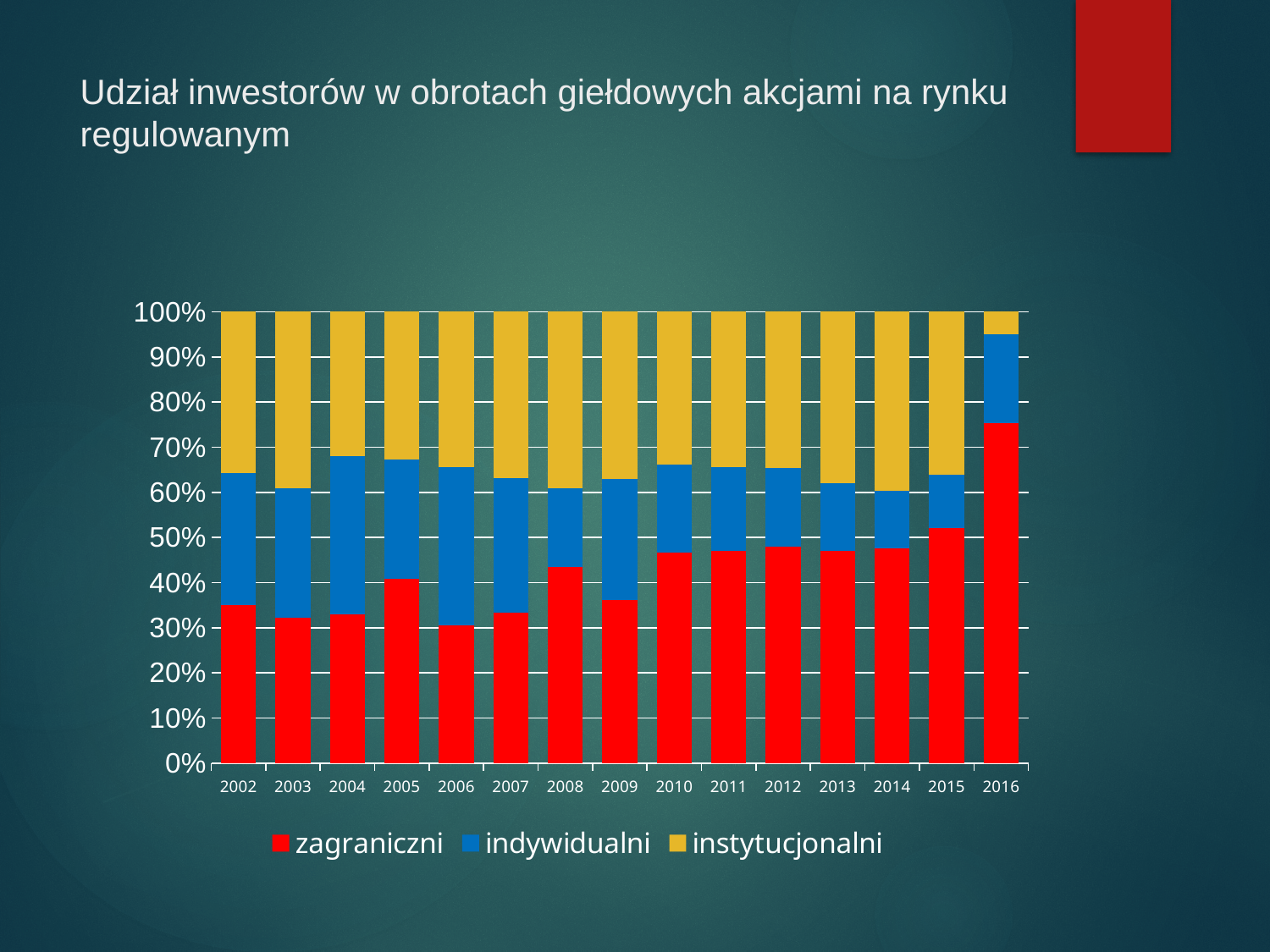
What is the total of the stacked bar for 2010? 100% How many series does the legend list? 3 Which is larger: the share of zagraniczni in 2016 or in 2002? 2016 Is the value for instytucjonalni in 2016 greater or less than 10%? less Which colour represents the series indywidualni in the legend? blue In which year is the share of zagraniczni (red) the highest? 2016 Is the value for zagraniczni in 2016 greater or less than 70%? greater Is the value for zagraniczni in 2002 greater or less than 40%? less How many years (categories) are shown on the x axis? 15 Does the share of zagraniczni generally rise or fall from 2002 to 2016? rise What kind of chart is shown on the slide? bar chart